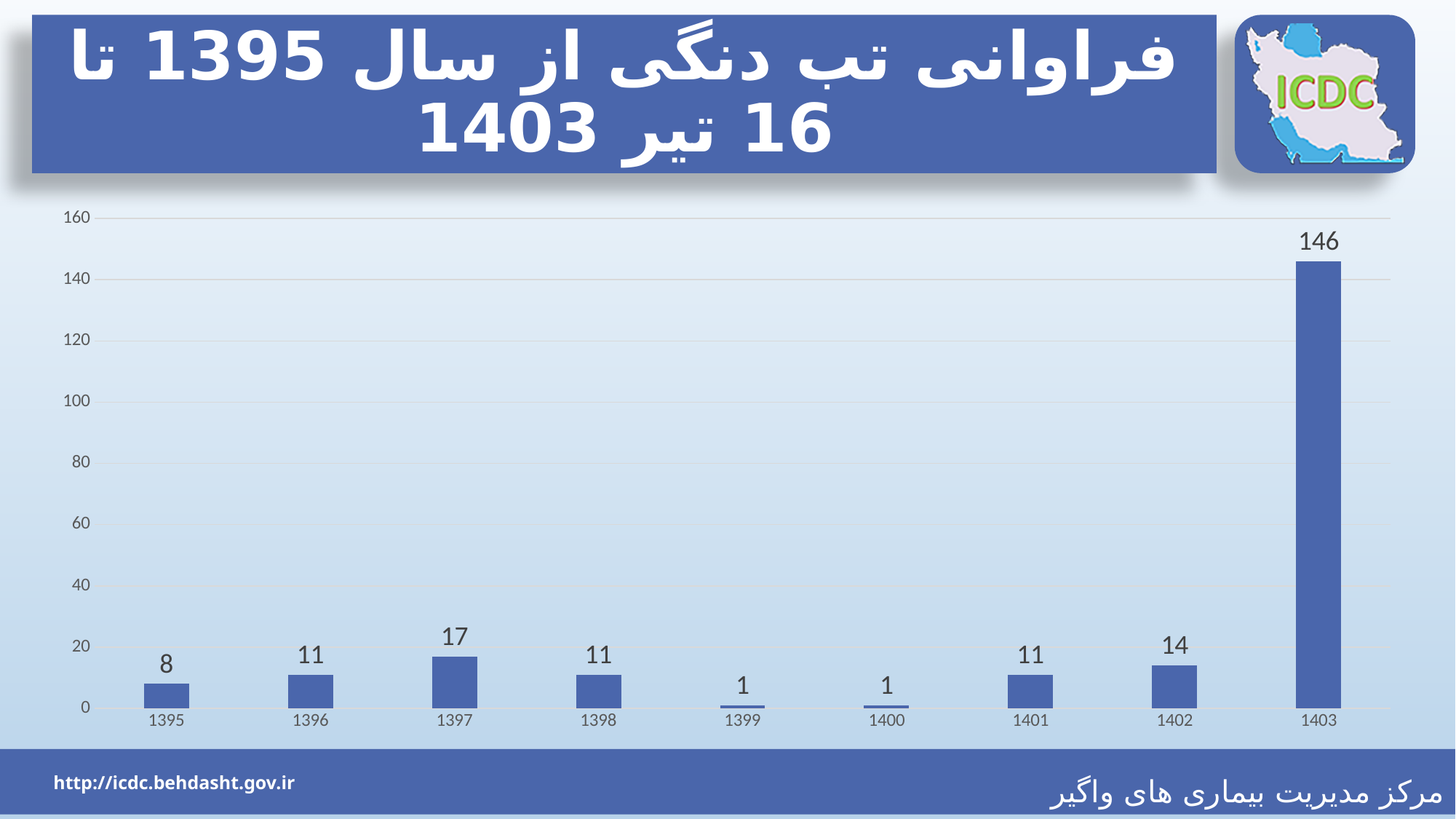
What is the difference between the values for 1403 and 1402? 132 Which is larger, the value for 1397 or the value for 1402? 1397 What is the value for 1403? 146 How many years are shown on the x axis? 9 What is the value for 1397? 17 What is the difference between the values for 1397 and 1395? 9 What kind of chart is shown on the slide? bar chart Which year has the highest value? 1403 What is the value for 1395? 8 What is the value for 1402? 14 Which years have the lowest value? 1399 and 1400 Is the value for 1403 greater or less than 140? greater